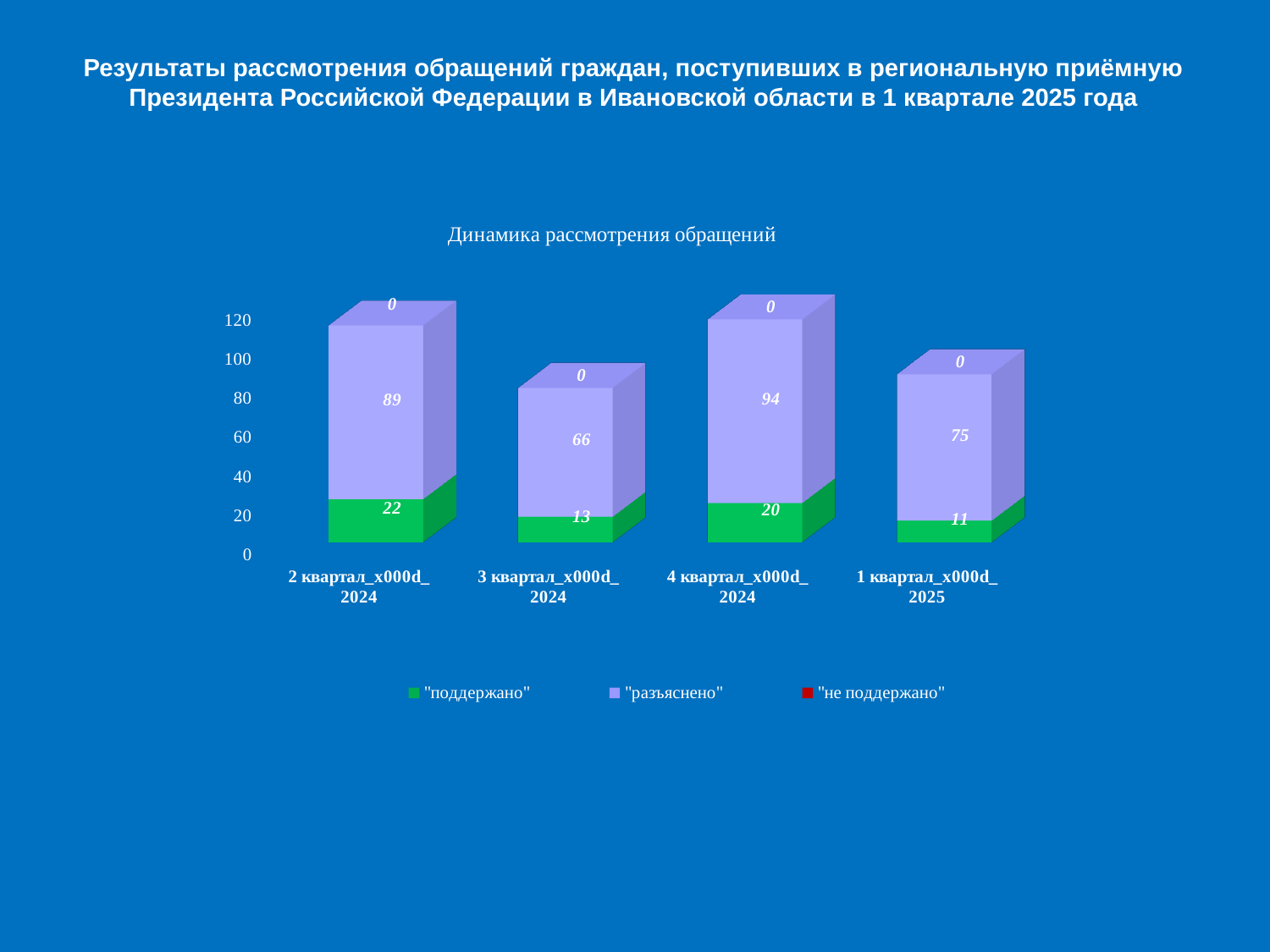
How many quarters are shown on the x axis? 4 What is the total of the stacked bar for 3 квартал 2024? 79 What is the value for "не поддержано" in 3 квартал 2024? 0 What type of chart is shown on the slide? Stacked bar chart What is the value for "поддержано" in 1 квартал 2025? 11 What is the value for "разъяснено" in 4 квартал 2024? 94 Which quarter has the highest value for "разъяснено"? 4 квартал 2024 What is the difference between the "разъяснено" values for 2 квартал 2024 and 3 квартал 2024? 23 Which quarter has the lowest value for "поддержано"? 1 квартал 2025 Which is larger: the "поддержано" value for 2 квартал 2024 or for 4 квартал 2024? 2 квартал 2024 What is the total of the stacked bar for 4 квартал 2024? 114 How many series does the legend list? 3